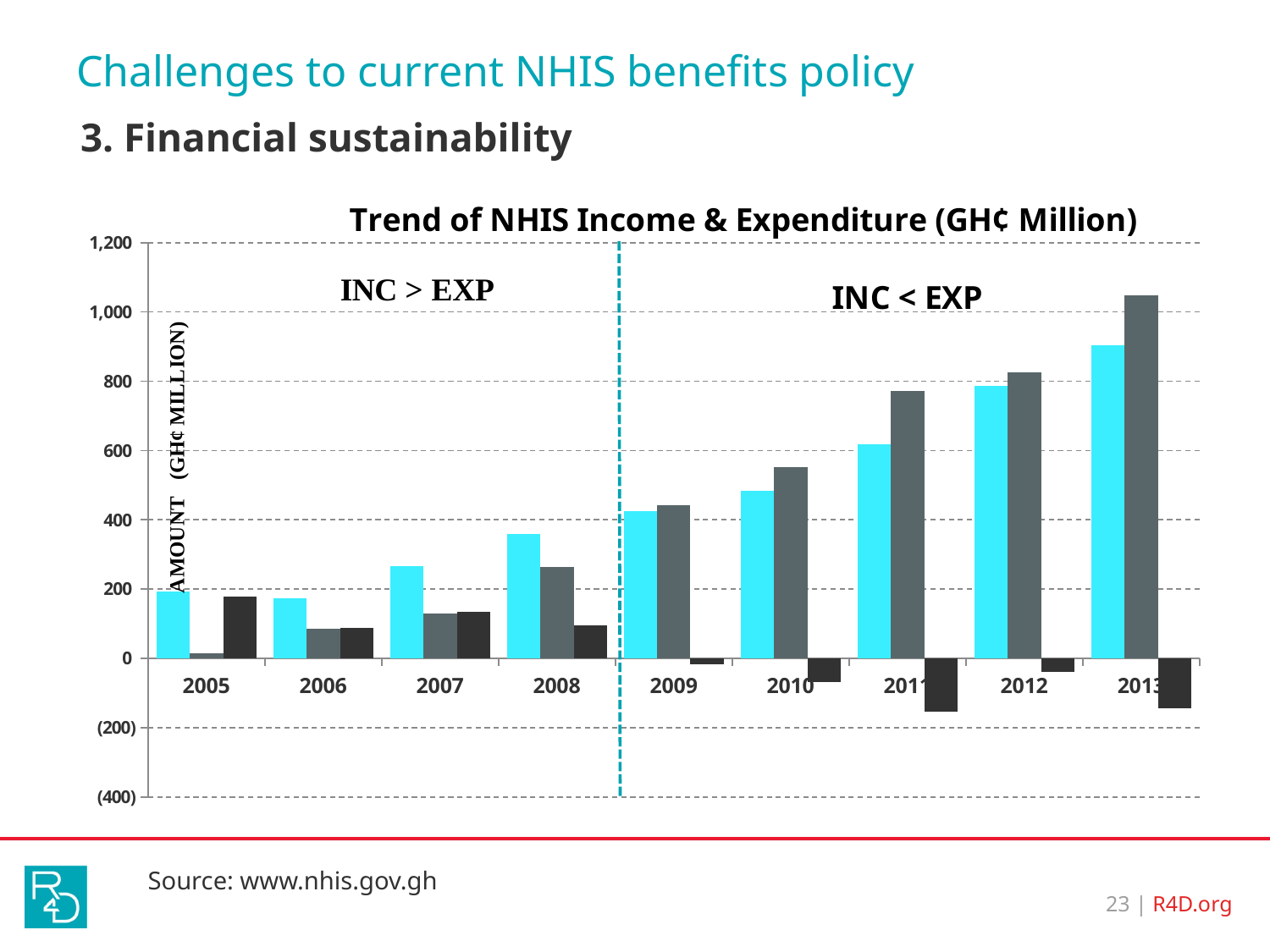
What label is written on the vertical axis of the chart? AMOUNT (GH¢ MILLION) Is the value of the cyan bar for 2013 greater or less than 800? greater Is the value of the grey bar for 2013 greater or less than 1,000? greater How many years are shown on the x axis of the chart? 9 In which year is the cyan bar the tallest? 2013 Is the value of the grey bar for 2010 greater or less than 600? less What type of chart is shown on the slide? bar chart In 2013, which bar is taller, the cyan bar or the grey bar? the grey bar In which year is the grey bar the tallest? 2013 What is the title of the chart? Trend of NHIS Income & Expenditure (GH¢ Million) Do the cyan bars generally rise or fall from 2005 to 2013? rise